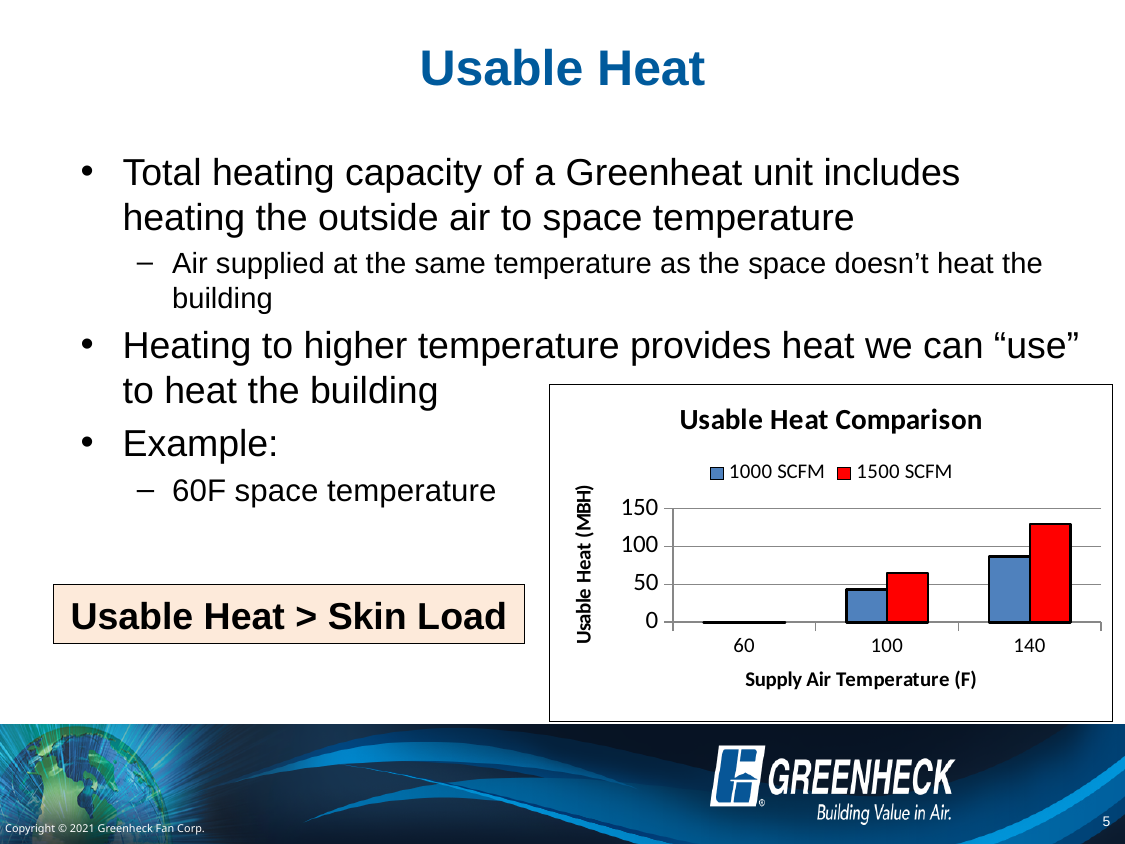
Do the usable heat values for 1500 SCFM rise or fall as supply air temperature increases? rise What kind of chart is shown on the slide? bar chart How many series does the chart legend list? 2 At which supply air temperature is the usable heat for 1500 SCFM highest? 140 How many supply air temperature categories are shown on the x axis? 3 Is the usable heat for 1000 SCFM at 140 F greater or less than 100? less Which series is shown in red? 1500 SCFM Is the usable heat for 1500 SCFM at 100 F greater or less than 50? greater Is the usable heat for 1500 SCFM at 140 F greater or less than 100? greater Which is larger at 140 F: the usable heat for 1000 SCFM or for 1500 SCFM? 1500 SCFM What is the title of the chart? Usable Heat Comparison